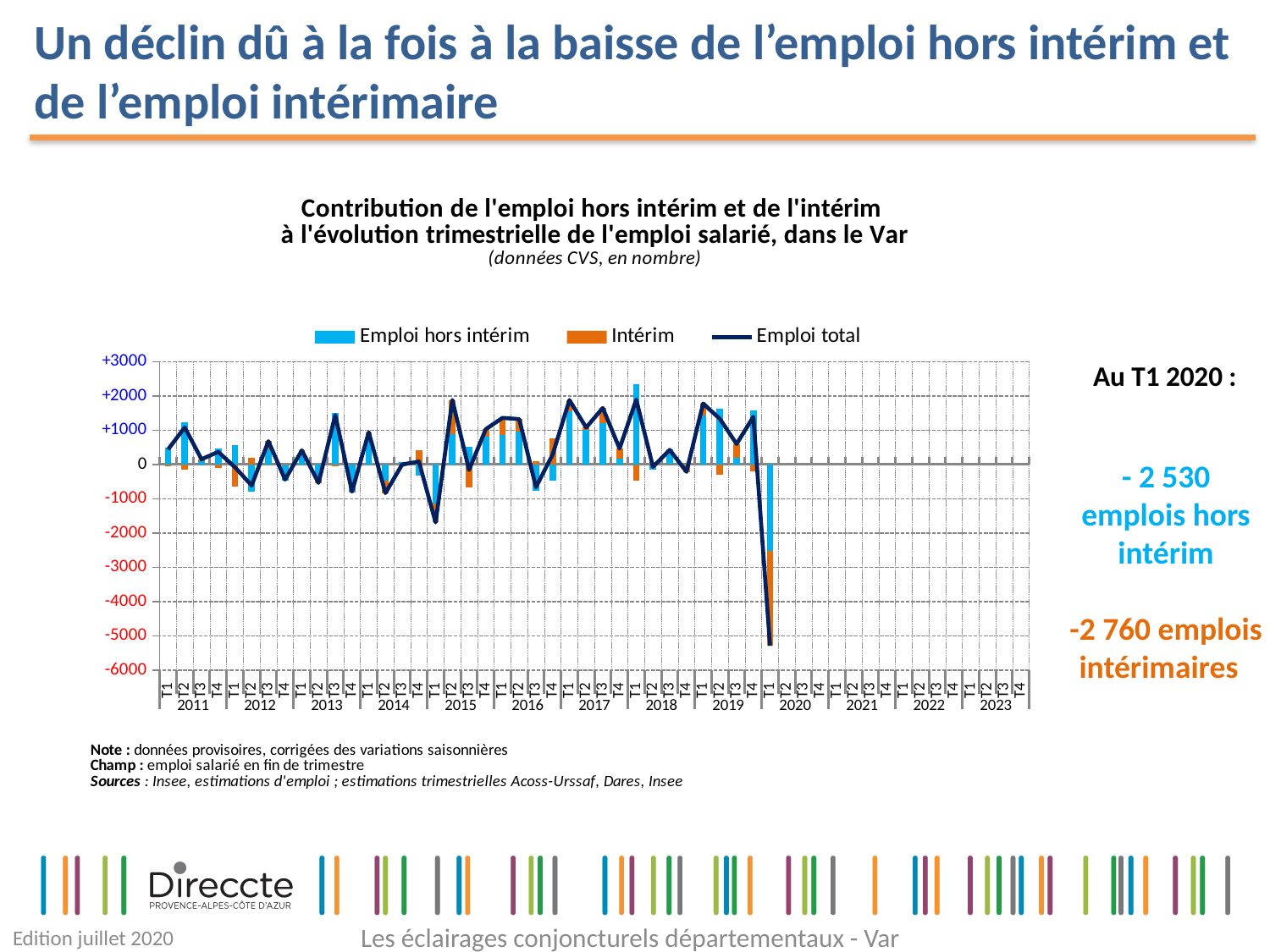
At T1 2020, which contributed a larger decline in absolute terms, Emploi hors intérim or Intérim? Intérim Is the Emploi total value at T1 2020 greater or less than -5000? less What is the value for Intérim at T1 2020? -2 760 What is the difference between the Intérim value and the Emploi hors intérim value at T1 2020? 230 In which quarter does the Emploi total line reach its lowest value? T1 2020 What kind of chart is shown? Combined bar and line chart What is the value for Emploi hors intérim at T1 2020? - 2 530 In which quarter is the Emploi hors intérim bar the highest? T1 2018 Is the Emploi hors intérim value at T1 2020 greater or less than -2000? less What is the total of the stacked bar at T1 2020 (Emploi hors intérim plus Intérim)? -5 290 Which series is drawn as a line rather than bars? Emploi total How many series does the legend list? 3